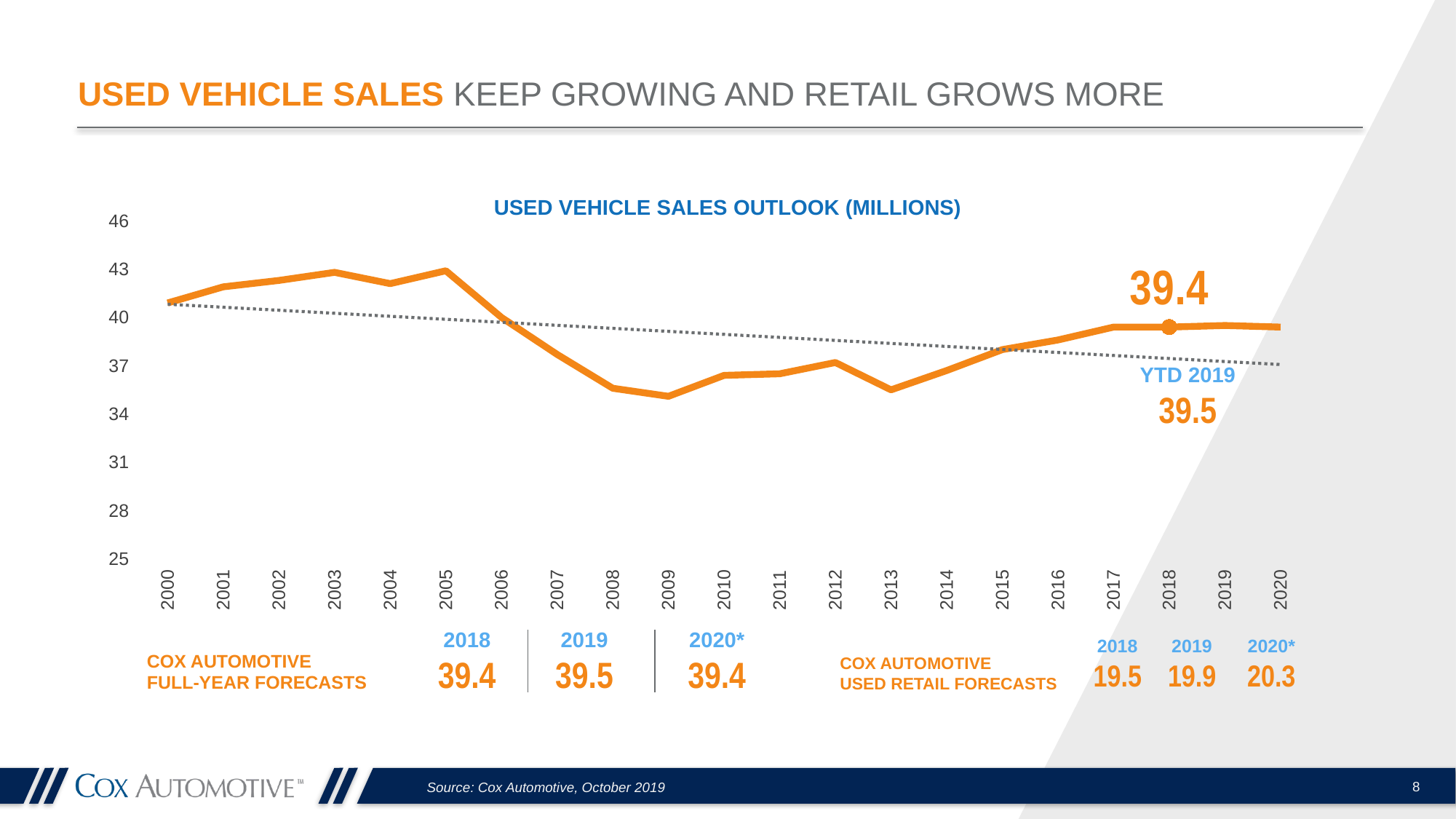
What value is labelled on the line for 2018? 39.4 How many years are shown on the x axis of the chart? 21 What kind of chart is shown on the slide? line chart Which is larger, the value for 2000 or the value for 2008? 2000 What is the Cox Automotive full-year forecast for 2020*? 39.4 What is the title of the chart? USED VEHICLE SALES OUTLOOK (MILLIONS) Is the value for 2009 greater or less than 37? less Do the values rise or fall from 2005 to 2009? fall Is the value for 2005 greater or less than 40? greater Do the values rise or fall from 2013 to 2017? rise What is the difference between the Cox Automotive used retail forecasts for 2020* and 2018? 0.8 Is the value for 2013 greater or less than 37? less